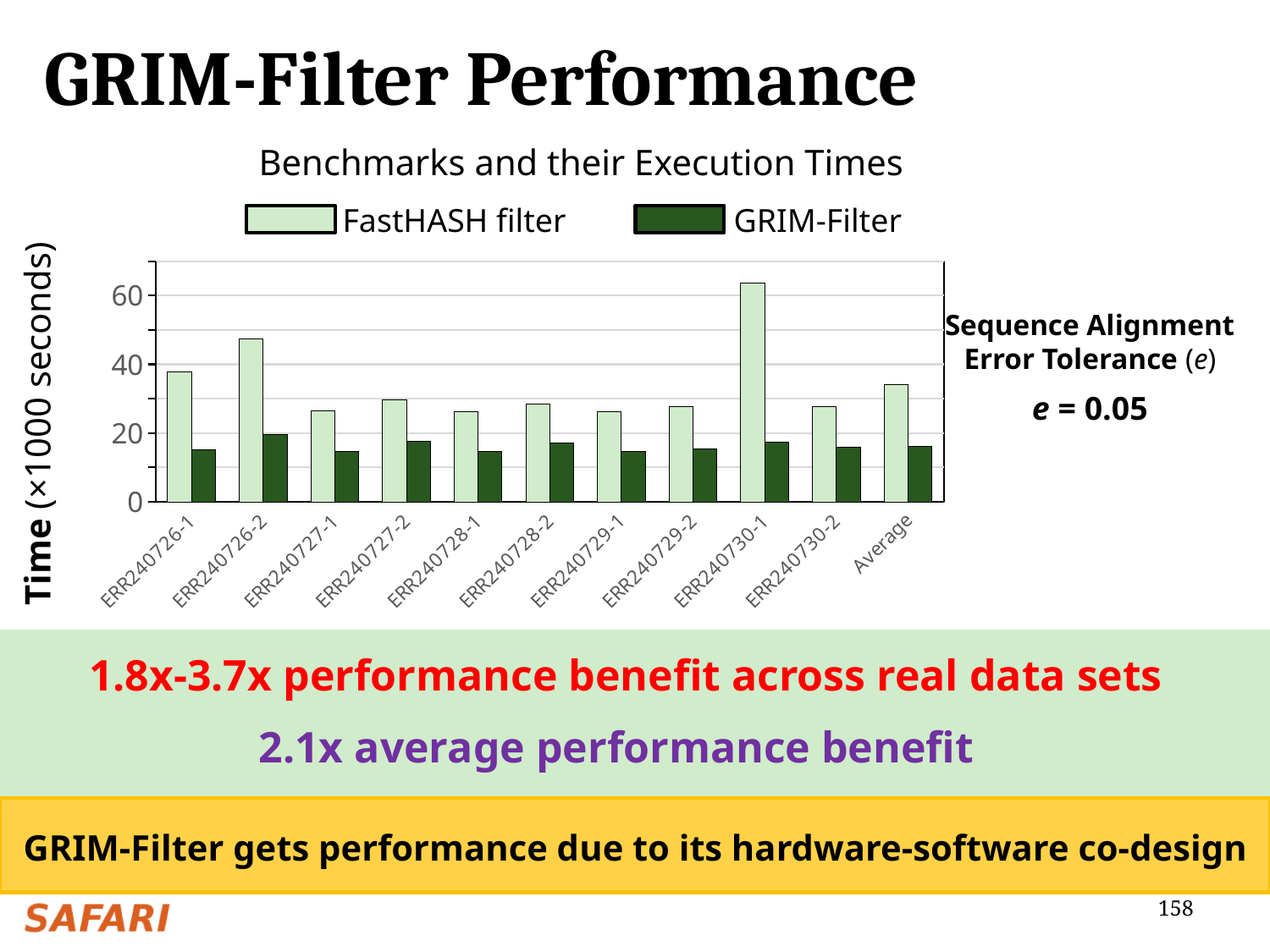
Is the FastHASH filter value for ERR240730-1 greater or less than 60? greater How many series does the legend list? 2 Is the GRIM-Filter value for ERR240726-1 greater or less than 20? less Which category has the highest FastHASH filter execution time? ERR240730-1 What is the label of the y axis of the chart? Time (×1000 seconds) What is the title of the chart? Benchmarks and their Execution Times For ERR240728-2, which series has the larger value, FastHASH filter or GRIM-Filter? FastHASH filter For the Average category, which series has the larger value, FastHASH filter or GRIM-Filter? FastHASH filter Is the FastHASH filter value for ERR240727-1 greater or less than 20? greater What kind of chart is shown on the slide? bar chart How many categories are shown on the x axis of the chart? 11